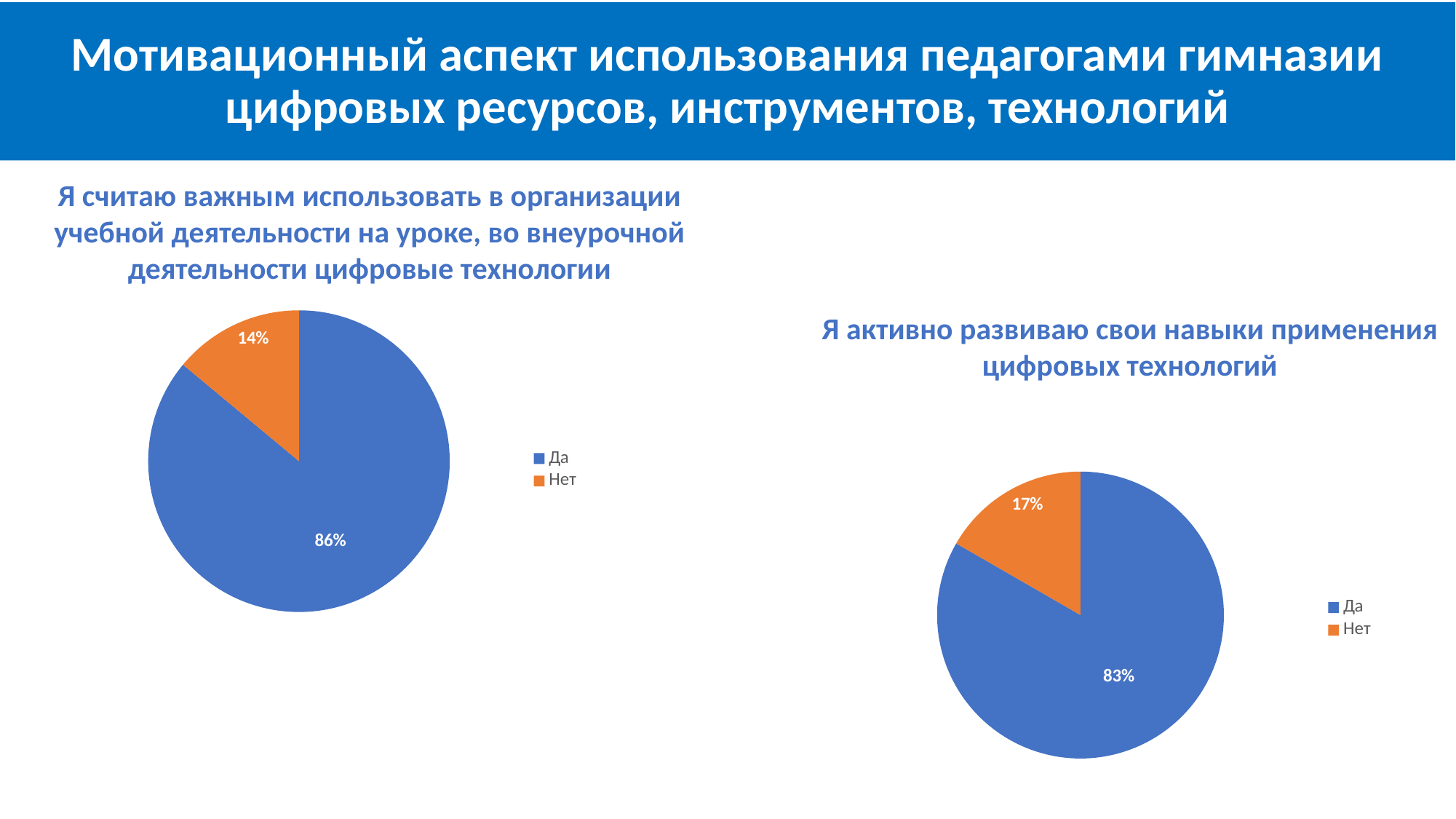
What colour is the "Нет" slice in the left pie chart? orange How many slices does the right pie chart have? 2 Which chart has the larger "Нет" share, the left pie chart or the right pie chart? the right pie chart In the left pie chart, what share of respondents answered "Да"? 86% In the right pie chart, what share of respondents answered "Нет"? 17% What type of chart is used on the left side of the slide? pie chart In the right pie chart, which answer has the smallest slice? Нет In the right pie chart, what is the difference in percentage points between the "Да" and "Нет" slices? 66 In the left pie chart, what is the difference in percentage points between the "Да" and "Нет" slices? 72 In the left pie chart, which answer has the largest slice? Да In the right pie chart, what share of respondents answered "Да"? 83% In the left pie chart, what share of respondents answered "Нет"? 14%